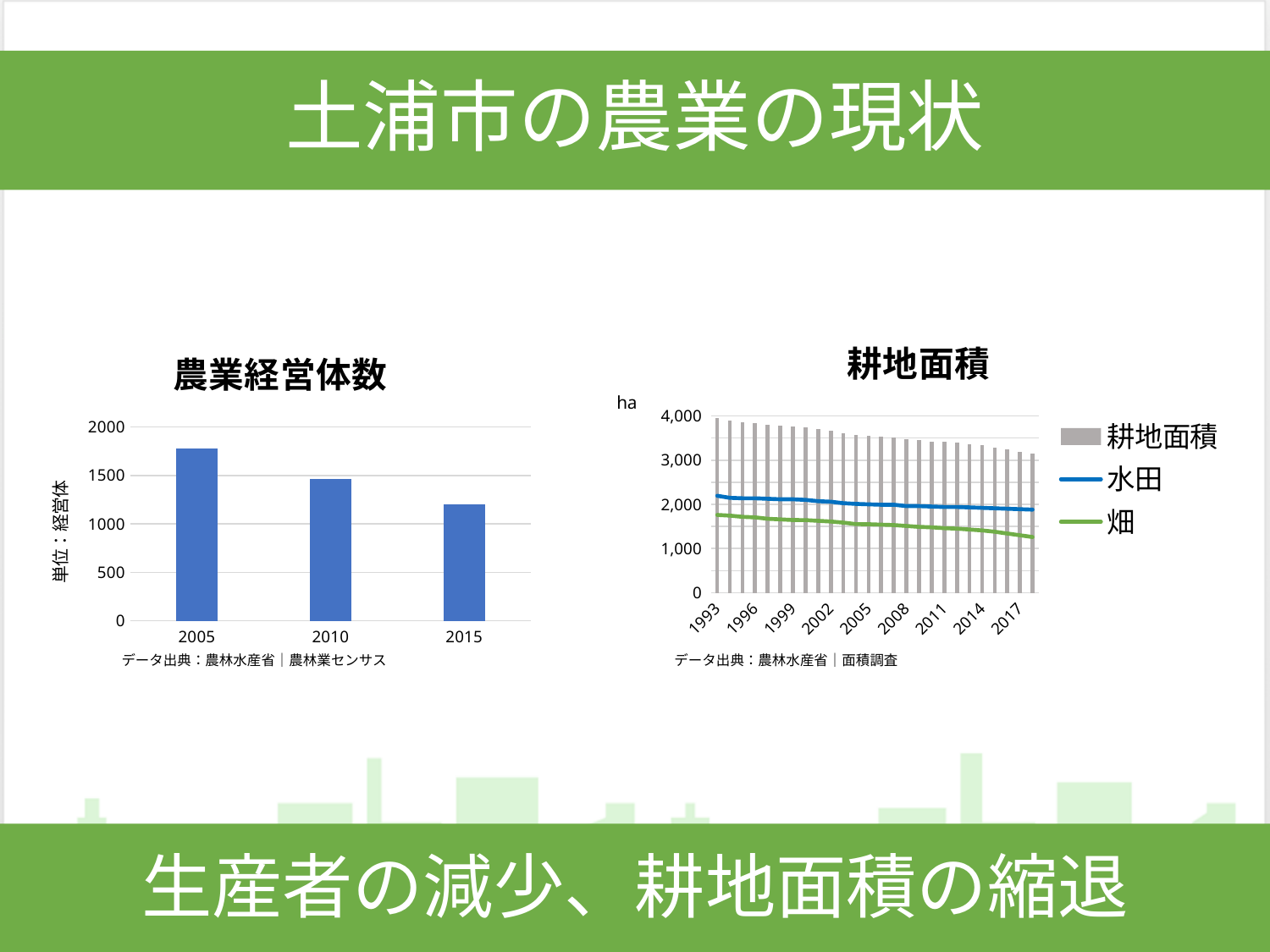
On the 農業経営体数 chart on the left, is the value for 2005 greater or less than 1500? greater On the 耕地面積 chart on the right, how many series does the legend list? 3 On the 農業経営体数 chart on the left, is the value for 2015 greater or less than 1500? less On the 農業経営体数 chart on the left, which year has the lowest value? 2015 On the 農業経営体数 chart on the left, what kind of chart is shown? bar chart On the 農業経営体数 chart on the left, do the values rise or fall from 2005 to 2015? fall On the 耕地面積 chart on the right, is the 畑 value in 2017 greater or less than 1,500? less On the 耕地面積 chart on the right, which series is larger in 2005, 水田 or 畑? 水田 On the 耕地面積 chart on the right, what unit is shown on the vertical axis? ha On the 農業経営体数 chart on the left, which year has the highest value? 2005 On the 農業経営体数 chart on the left, how many years are plotted? 3